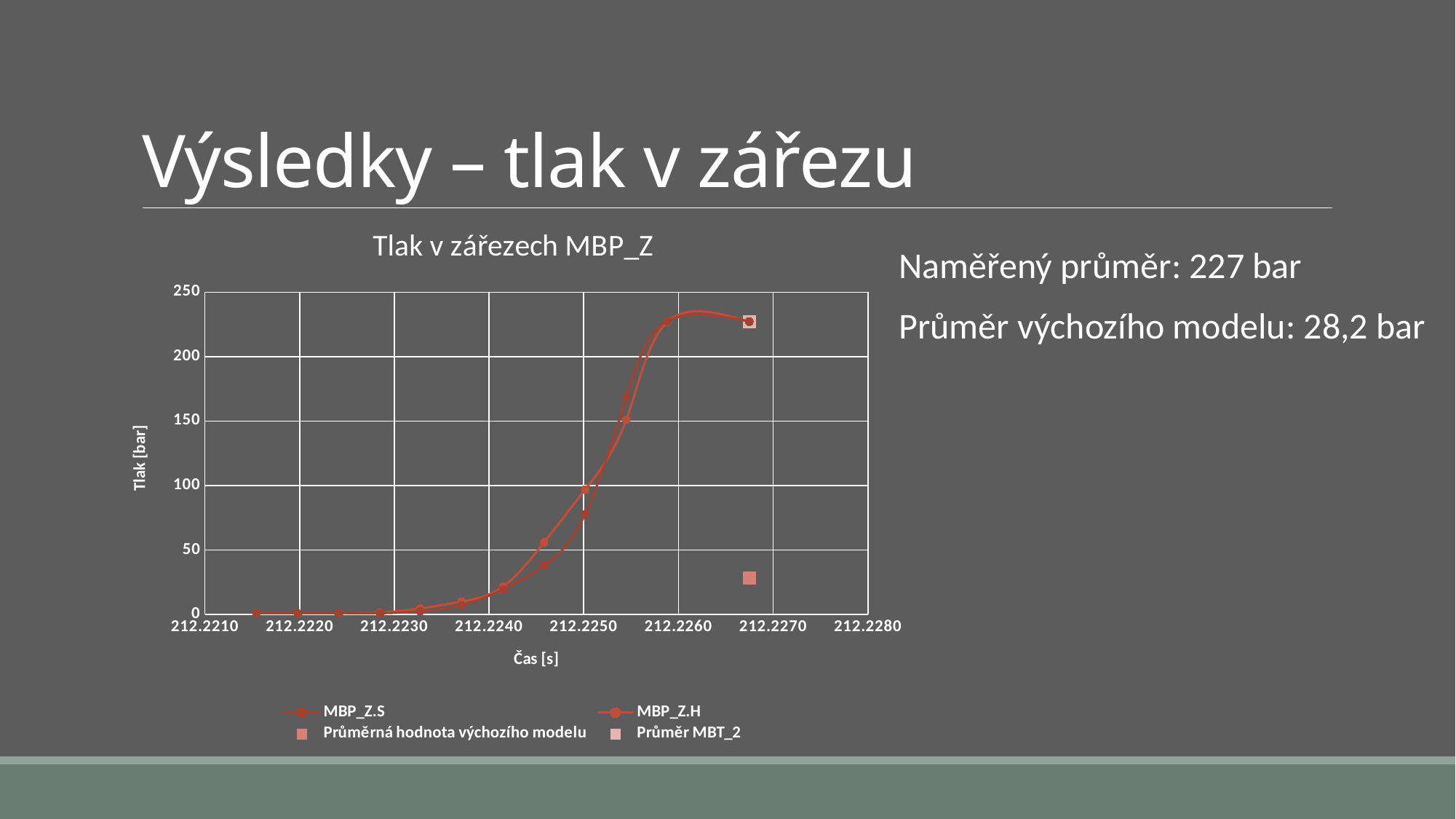
How many series does the chart legend list? 4 Is the value of the lower square marker near 212.2270 greater or less than 50? less How many tick labels are shown on the horizontal axis of the chart? 8 Is the value of the upper square marker near 212.2270 greater or less than 200? greater What is the highest value shown on the vertical axis of the chart? 250 What kind of chart is shown on the slide? line chart What is the label of the vertical axis of the chart? Tlak [bar] Which of the two square markers has the larger value: the upper one or the lower one? the upper one What is the title of the chart? Tlak v zářezech MBP_Z Is the peak value of the MBP_Z.H curve greater or less than 200? greater Do the MBP_Z.S and MBP_Z.H curves rise or fall as time increases along the x axis? rise